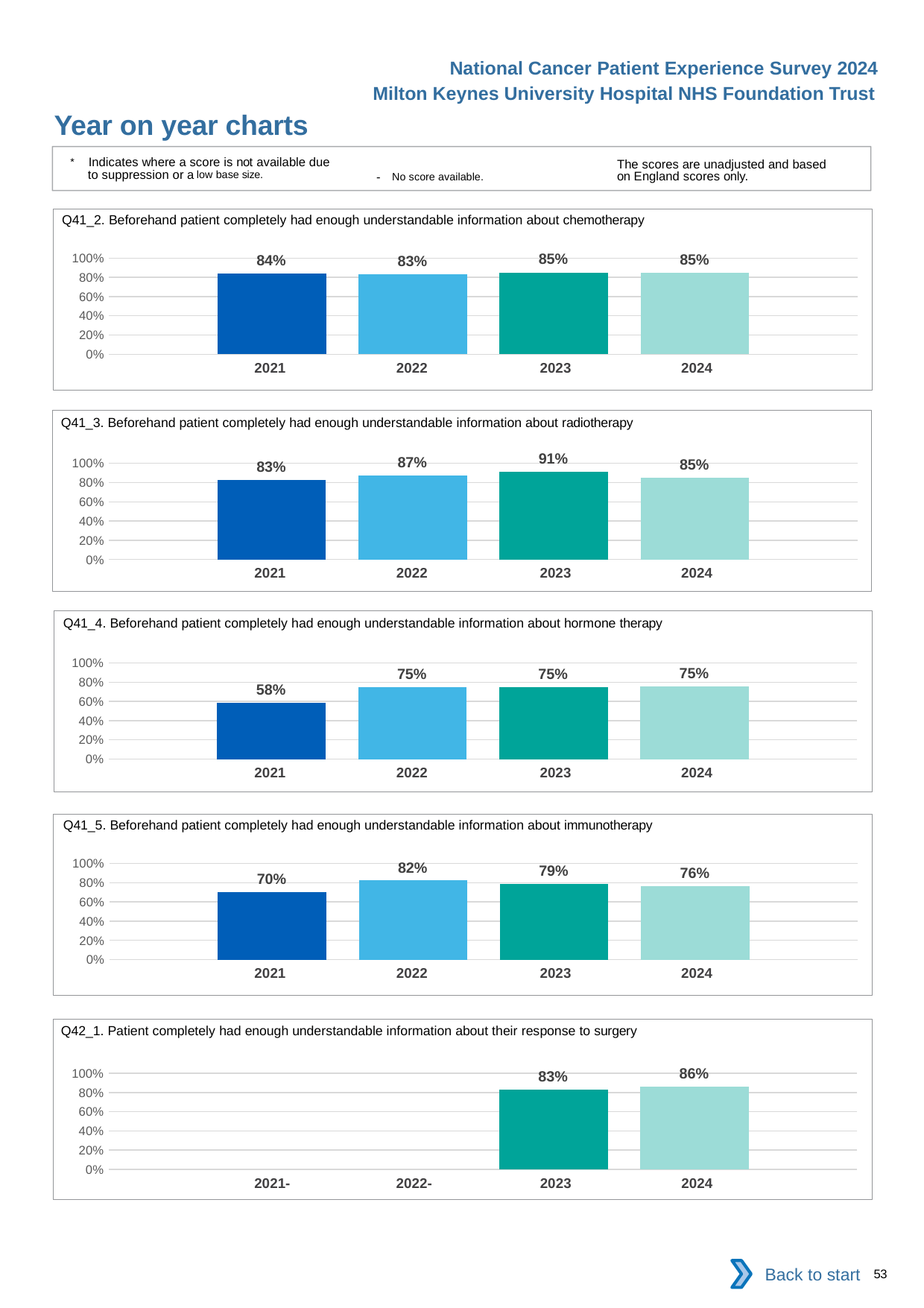
In the Q42_1 chart about response to surgery, how many years have a bar plotted? 2 In the Q41_5 chart about immunotherapy, what is the difference between the 2022 and 2021 values? 12% In the Q41_4 chart about hormone therapy, what is the value for 2022? 75% What kind of chart is the Q41_3 chart about radiotherapy? Bar chart In the Q41_4 chart about hormone therapy, how many years are shown on the x axis? 4 In the Q41_5 chart about immunotherapy, which is larger, the value for 2022 or the value for 2024? 2022 In the Q41_3 chart about radiotherapy, which year has the highest value? 2023 In the Q41_4 chart about hormone therapy, which year has the lowest value? 2021 In the Q42_1 chart about response to surgery, what is the value for 2024? 86% In the Q41_2 chart about chemotherapy, is the value for 2022 greater or less than 80%? greater In the Q41_3 chart about radiotherapy, what is the difference between the 2023 and 2024 values? 6% In the Q41_2 chart about chemotherapy, what is the value for 2021? 84%